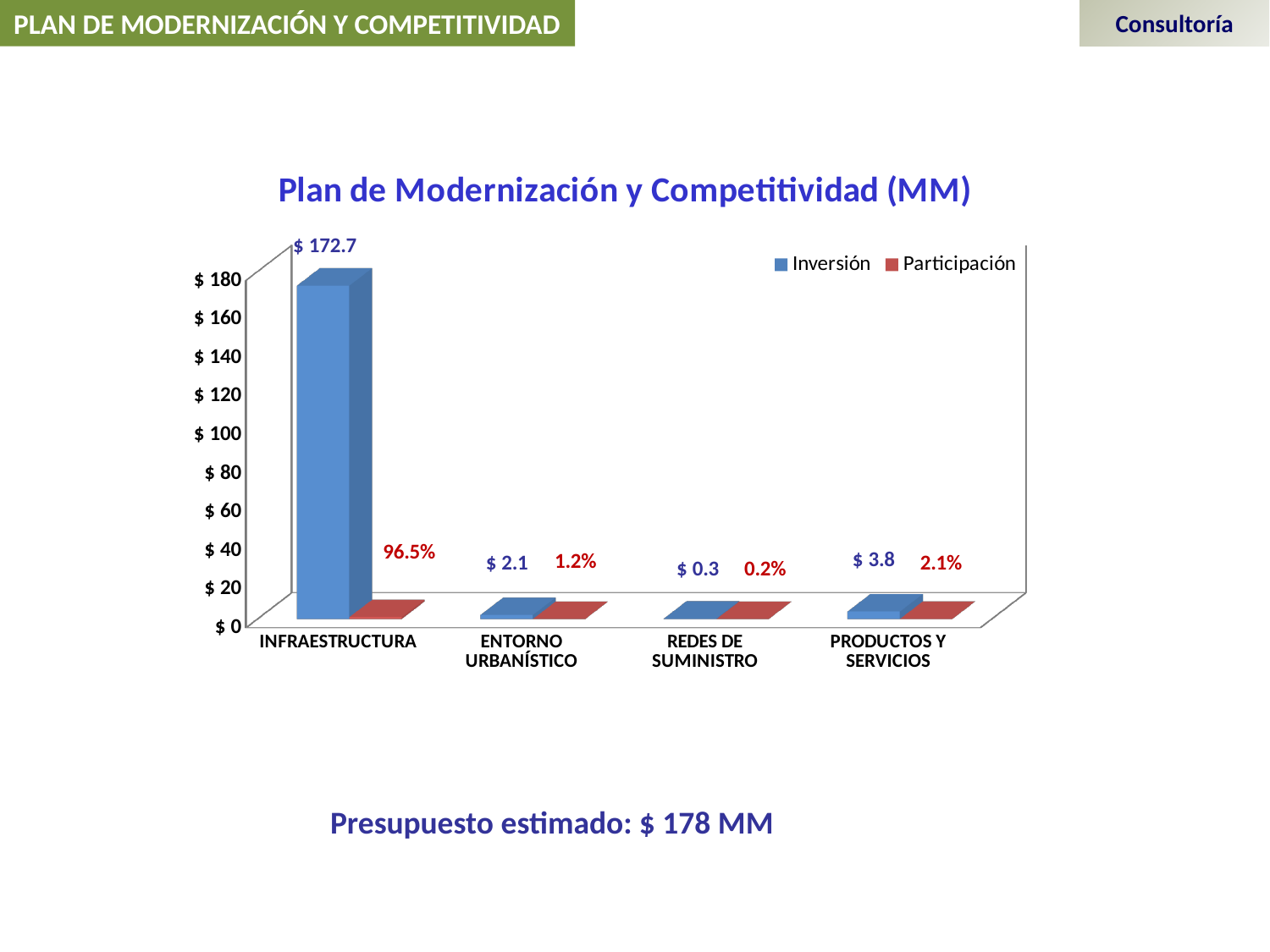
What is the difference between the Inversión values for PRODUCTOS Y SERVICIOS and ENTORNO URBANÍSTICO? $ 1.7 Which category has the highest Inversión value? INFRAESTRUCTURA What is the Participación value for PRODUCTOS Y SERVICIOS? 2.1% What kind of chart is shown on the slide? bar chart How many categories are shown on the x axis? 4 Which has a larger Inversión value, ENTORNO URBANÍSTICO or PRODUCTOS Y SERVICIOS? PRODUCTOS Y SERVICIOS What is the Inversión value for INFRAESTRUCTURA? $ 172.7 Is the Inversión value for INFRAESTRUCTURA greater or less than $ 160? greater What is the Inversión value for REDES DE SUMINISTRO? $ 0.3 Which category has the lowest Participación value? REDES DE SUMINISTRO What is the Participación value for ENTORNO URBANÍSTICO? 1.2% How many series does the legend list? 2